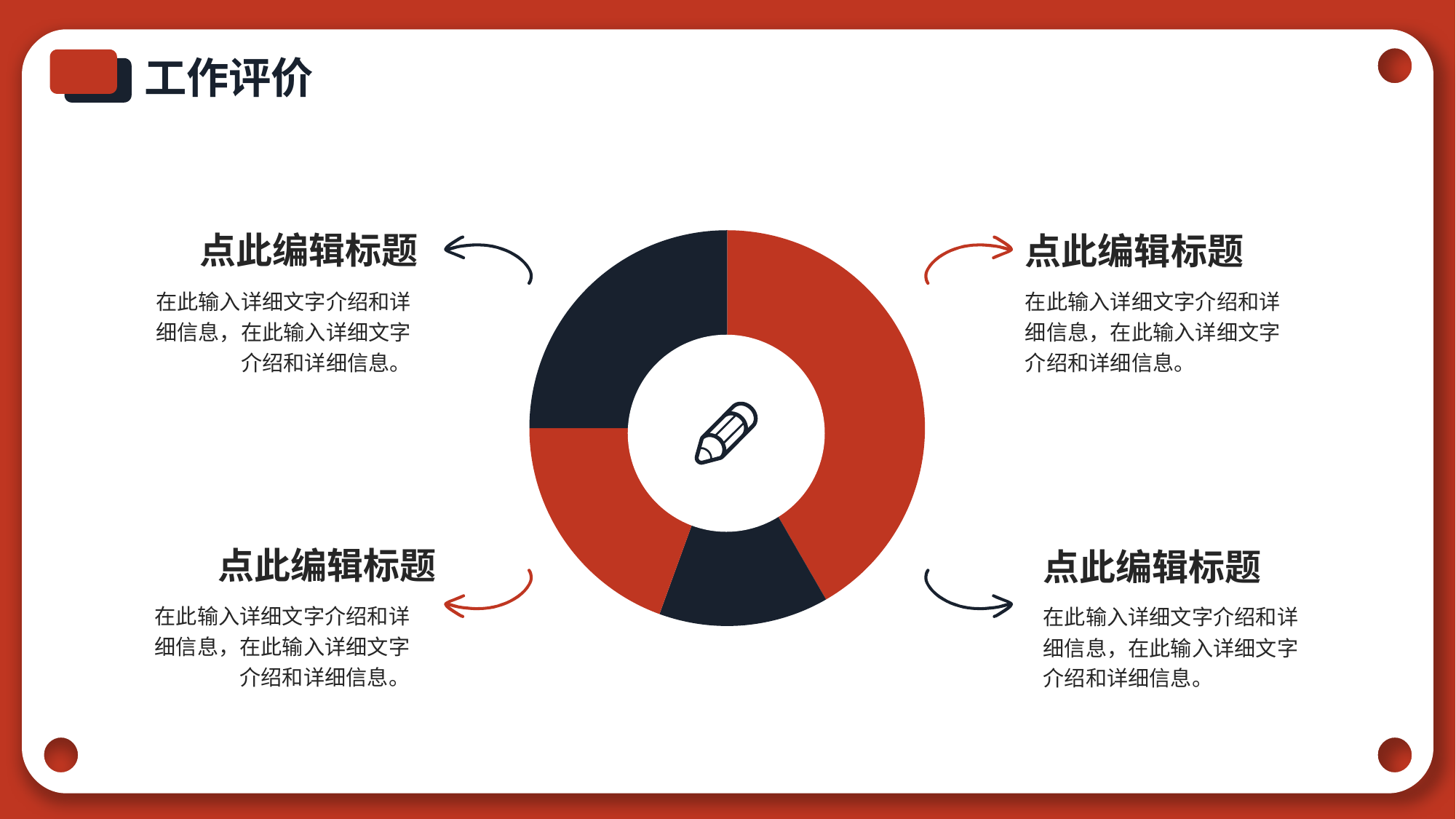
What kind of chart is shown on the slide? Doughnut (pie) chart Which is larger: the dark segment at the top left or the red segment at the lower left? The dark segment at the top left What is the title of the slide containing the doughnut chart? 工作评价 What two colours are used for the segments of the doughnut chart? Red and dark navy How many segments does the doughnut chart have? 4 Which segment of the doughnut chart is the smallest? The dark segment at the bottom Which segment of the doughnut chart is the largest? The red segment on the right Which is larger: the red segment on the right or the red segment on the lower left? The red segment on the right